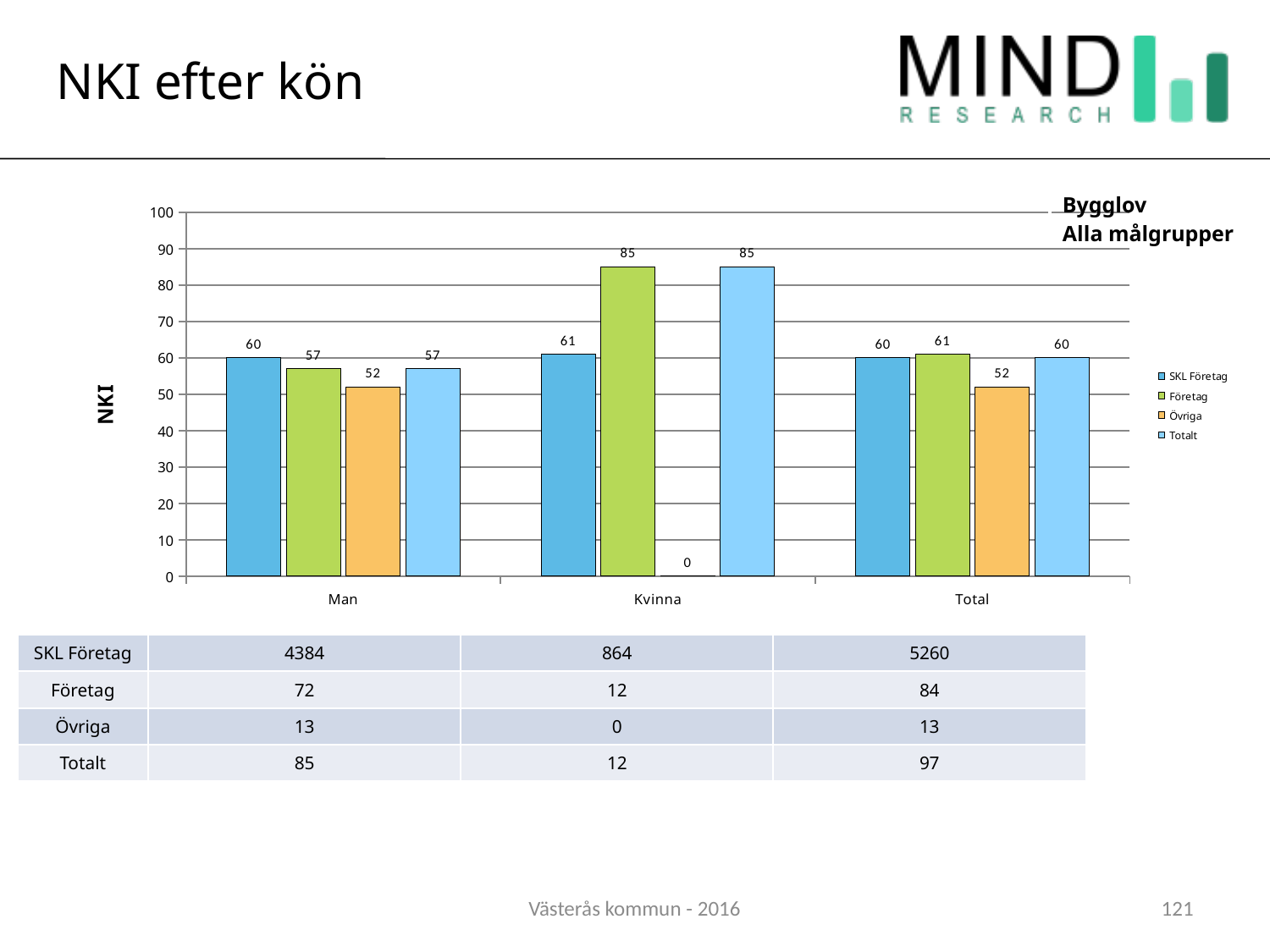
What is the NKI value for Övriga in the Kvinna category? 0 Which series has the lowest value in the Kvinna category? Övriga What is the label of the y axis of the chart? NKI What is the NKI value for SKL Företag in the Total category? 60 Which series has the highest value in the Man category? SKL Företag How many series does the chart legend list? 4 What is the difference between the Företag value for Kvinna and the Företag value for Man? 28 Which is larger: the Totalt value for Kvinna or the Totalt value for Man? Kvinna What type of chart is shown on the slide? Bar chart What is the NKI value for Företag in the Kvinna category? 85 What is the NKI value for Övriga in the Man category? 52 How many categories are shown on the x axis of the chart? 3